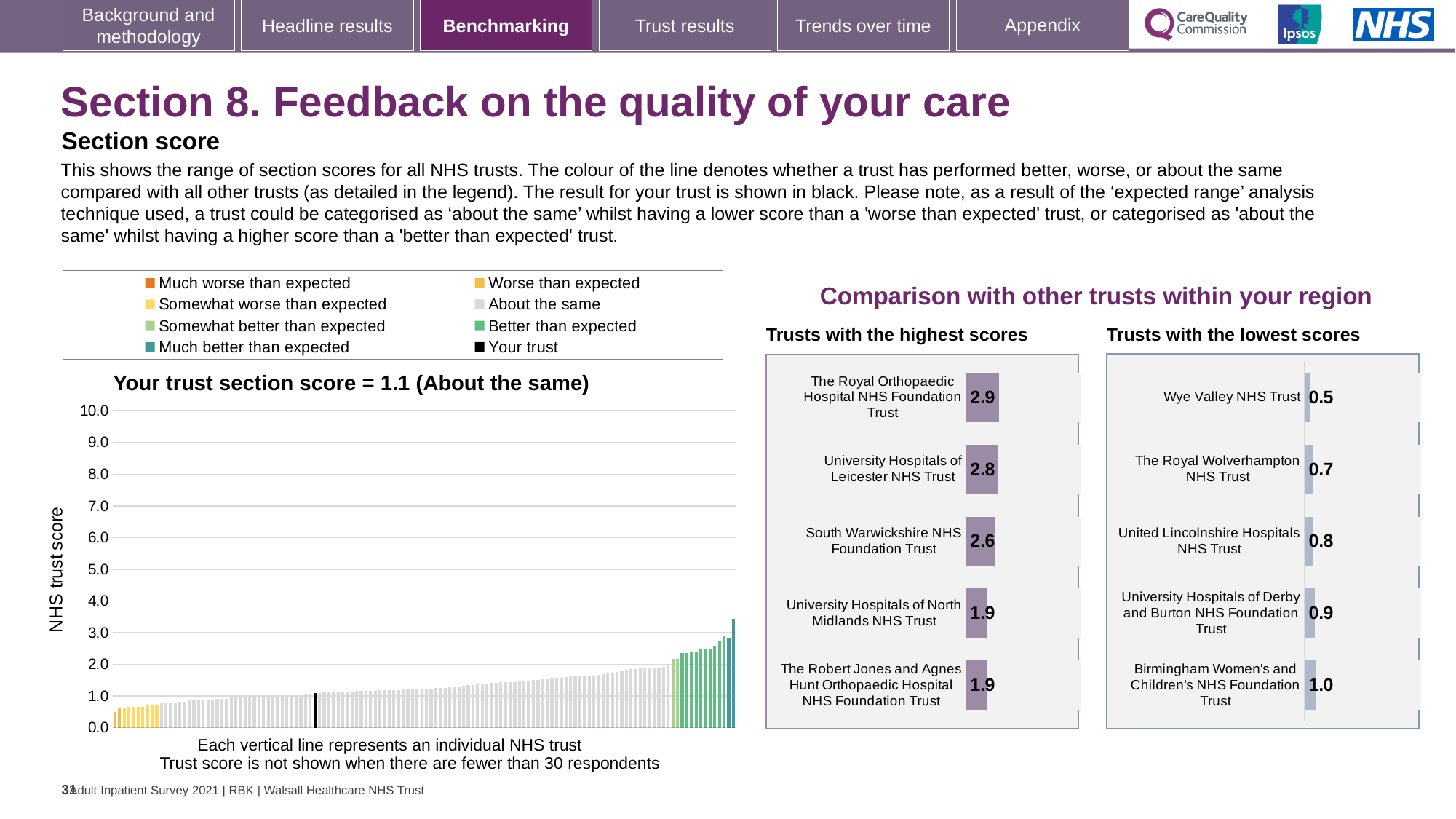
In the 'Trusts with the highest scores' chart, what is the score for University Hospitals of Leicester NHS Trust? 2.8 In the 'Your trust section score' chart, is the value of the tallest bar greater or less than 3.0? greater In the 'Trusts with the lowest scores' chart, which has the larger score: The Royal Wolverhampton NHS Trust or United Lincolnshire Hospitals NHS Trust? United Lincolnshire Hospitals NHS Trust What kind of chart is the 'Your trust section score' chart? bar chart In the 'Trusts with the lowest scores' chart, which trust has the lowest score? Wye Valley NHS Trust In the 'Trusts with the lowest scores' chart, how many trusts are shown? 5 In the 'Your trust section score' chart, do the bars rise or fall from left to right? rise In the 'Trusts with the highest scores' chart, which trust has the highest score? The Royal Orthopaedic Hospital NHS Foundation Trust In the 'Trusts with the highest scores' chart, what is the difference between the scores of The Royal Orthopaedic Hospital NHS Foundation Trust and South Warwickshire NHS Foundation Trust? 0.3 In the 'Your trust section score' chart, what colour represents your trust according to the legend? black In the 'Your trust section score' chart, how many entries does the legend list? 8 In the 'Your trust section score' chart, what is the section score for your trust? 1.1